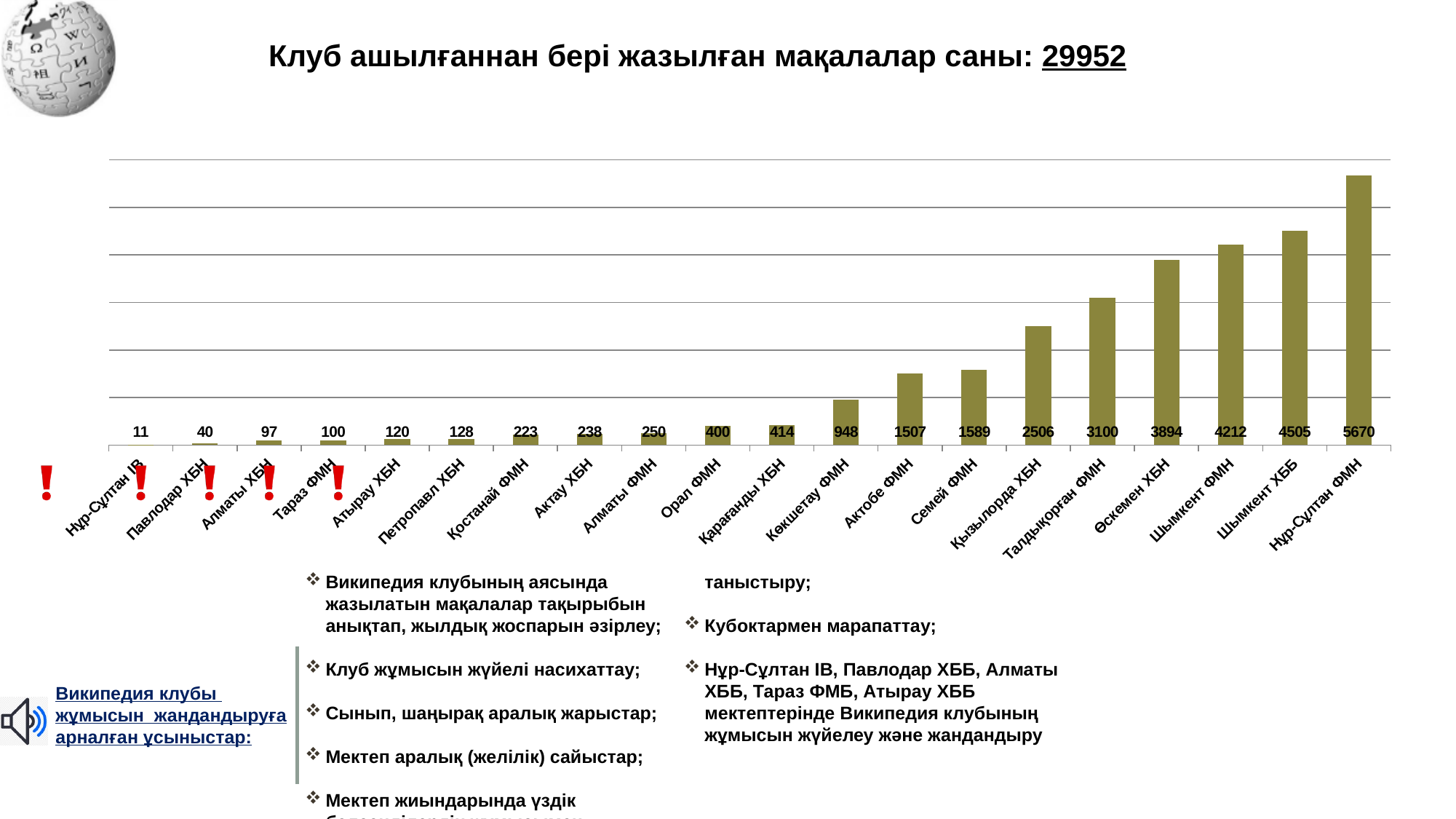
What is the value for Көкшетау ФМН? 948 What is the difference between the values for Шымкент ХББ and Шымкент ФМН? 293 Which is larger, the value for Өскемен ХБН or the value for Талдықорған ФМН? Өскемен ХБН What is the value for Қызылорда ХБН? 2506 Which category has the lowest value? Нұр-Сұлтан IB Which category has the highest value? Нұр-Сұлтан ФМН What kind of chart is shown? bar chart What total number is given in the slide title? 29952 How many categories are shown on the x axis? 20 What is the value for Нұр-Сұлтан ФМН? 5670 Do the values rise or fall from left to right along the x axis? rise What is the value for Тараз ФМН? 100